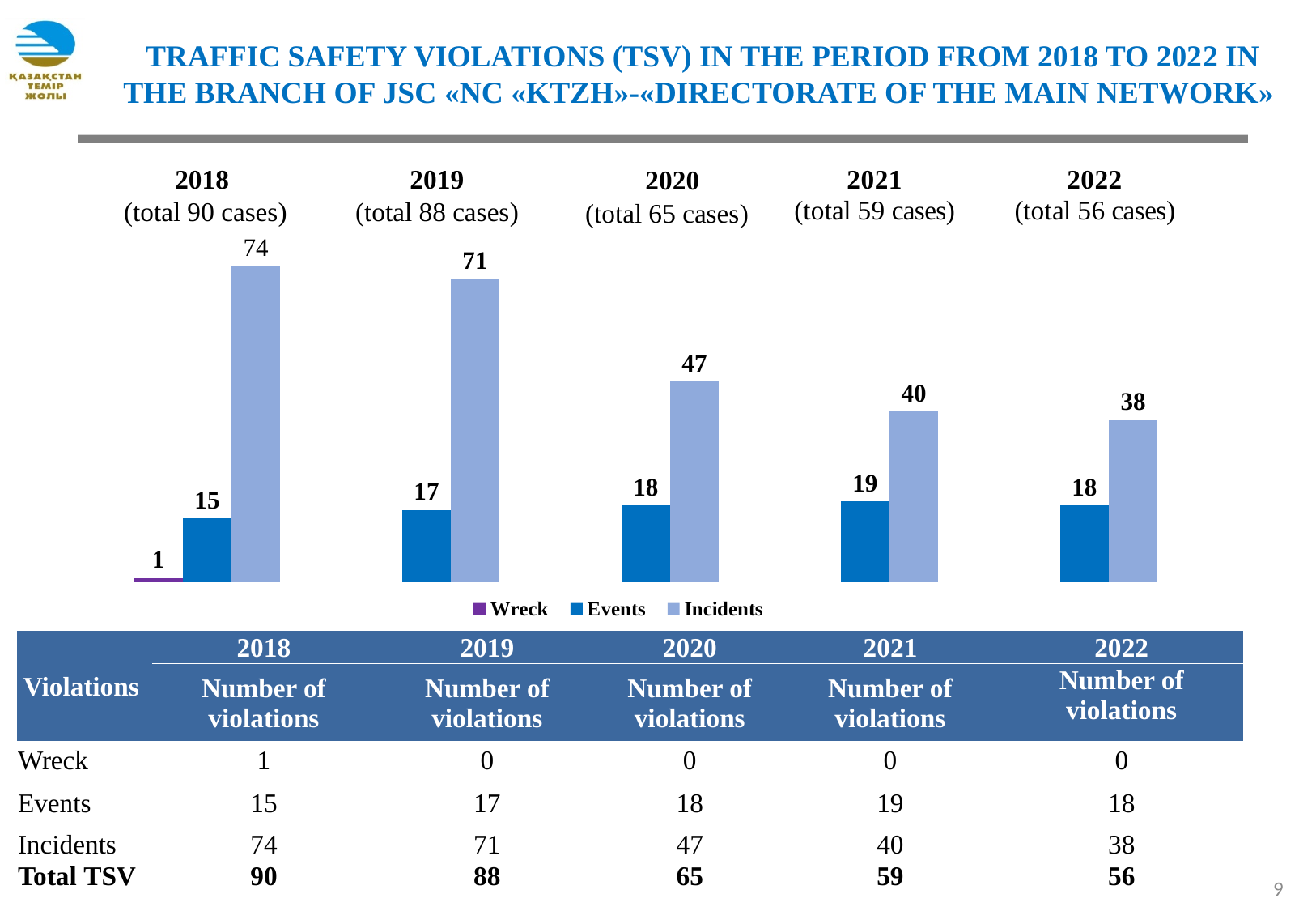
What kind of chart is shown on the slide? bar chart What is the difference between the number of Incidents in 2019 and in 2020? 24 Which year has the lowest number of Incidents? 2022 What is the number of Incidents in 2018? 74 What is the total number of TSV cases in 2020? 65 What is the number of Events in 2021? 19 How many years are shown on the chart? 5 Which is larger, the number of Events in 2019 or the number of Events in 2020? 2020 What is the number of Wreck cases in 2018? 1 Do the Incidents values rise or fall from 2018 to 2022? fall Which year has the highest number of Incidents? 2018 How many series does the legend list? 3